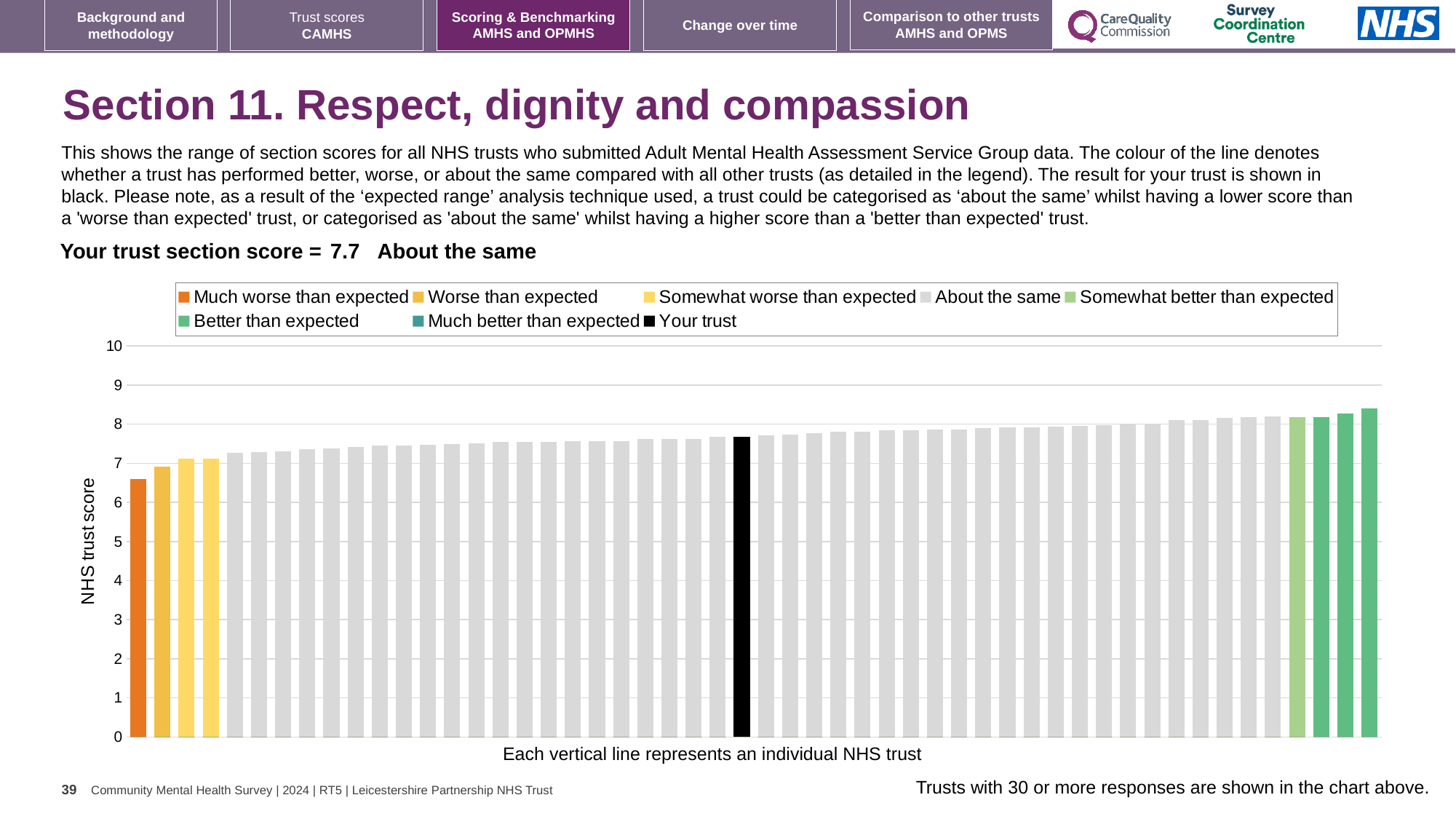
Is the value for your trust (the black bar) greater or less than 7? greater Which legend category does the lowest bar in the chart belong to? Much worse than expected Is the value for your trust (the black bar) greater or less than 8? less What is your trust's section score as printed on the slide? 7.7 What kind of chart is shown on the slide? bar chart Do the bar values rise or fall from left to right along the x axis? rise How many entries does the chart legend list? 8 Is the value of the rightmost bar greater or less than 8? greater What is the label on the vertical axis of the chart? NHS trust score How many bars in the chart are coloured orange (Much worse than expected)? 1 Which is higher, the black bar for your trust or the orange bar at the far left? the black bar (your trust)